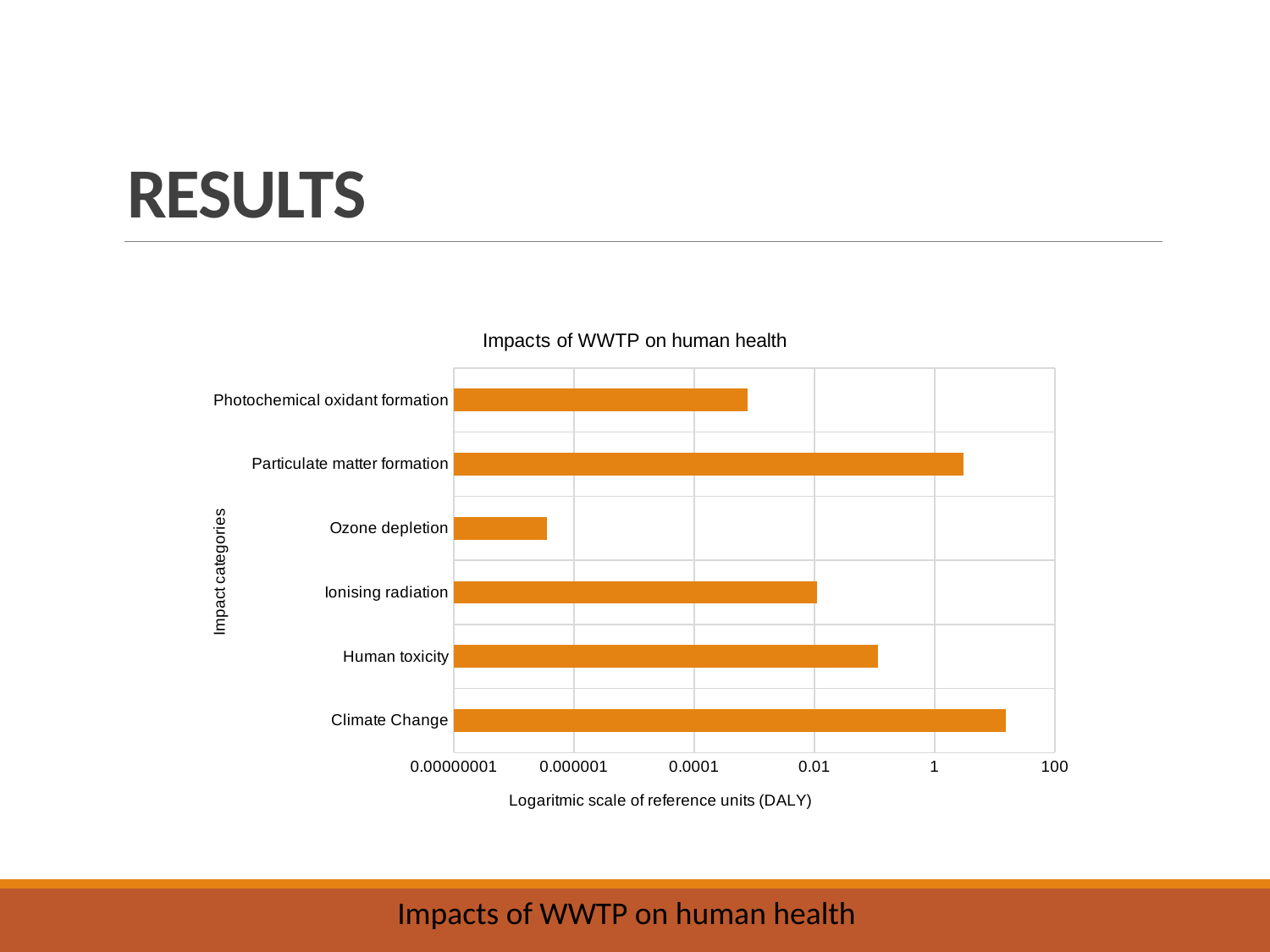
Which has the larger value, Human toxicity or Photochemical oxidant formation? Human toxicity Which impact category has the lowest value? Ozone depletion Is the value for Particulate matter formation greater or less than 1? greater Is the value for Photochemical oxidant formation greater or less than 0.01? less Is the value for Human toxicity greater or less than 0.01? greater What is the title of the chart? Impacts of WWTP on human health Which impact category has the highest value? Climate Change How many impact categories are plotted in the chart? 6 What type of chart is shown on the slide? bar chart Which has the larger value, Particulate matter formation or Ionising radiation? Particulate matter formation